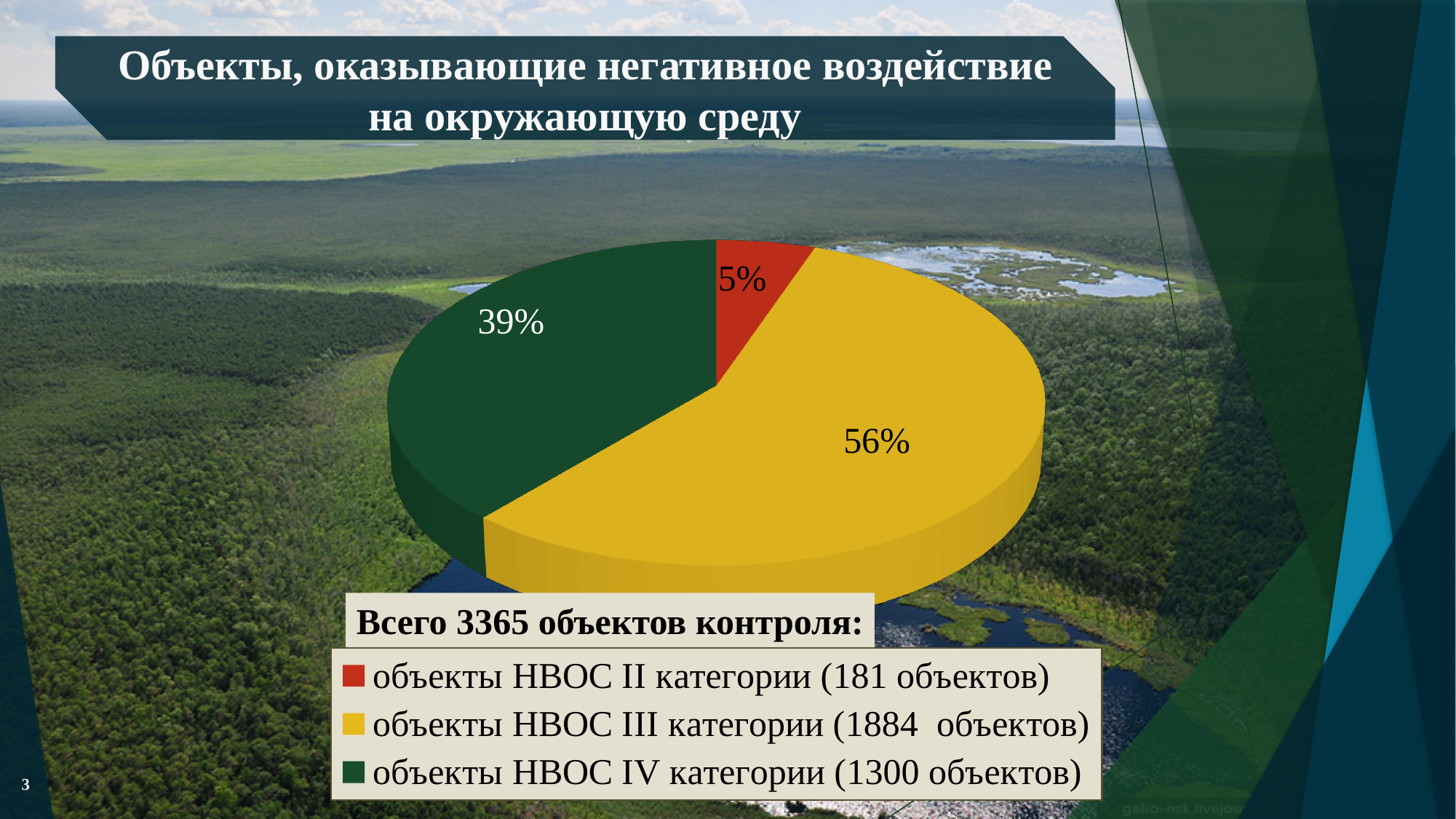
How many objects are listed for объекты НВОС IV категории in the legend? 1300 объектов What colour is the slice for объекты НВОС II категории? red How many slices does the pie chart have? 3 Which is larger: the share for объекты НВОС IV категории or the share for объекты НВОС II категории? объекты НВОС IV категории What percentage share does the slice for объекты НВОС III категории have? 56% Which category has the smallest slice of the pie? объекты НВОС II категории What is the difference in percentage points between the III категории slice and the IV категории slice? 17% Which category has the largest slice of the pie? объекты НВОС III категории What percentage share does the slice for объекты НВОС II категории have? 5% How many objects are listed for объекты НВОС III категории in the legend? 1884 объектов What kind of chart is shown on the slide? pie chart What percentage share does the slice for объекты НВОС IV категории have? 39%